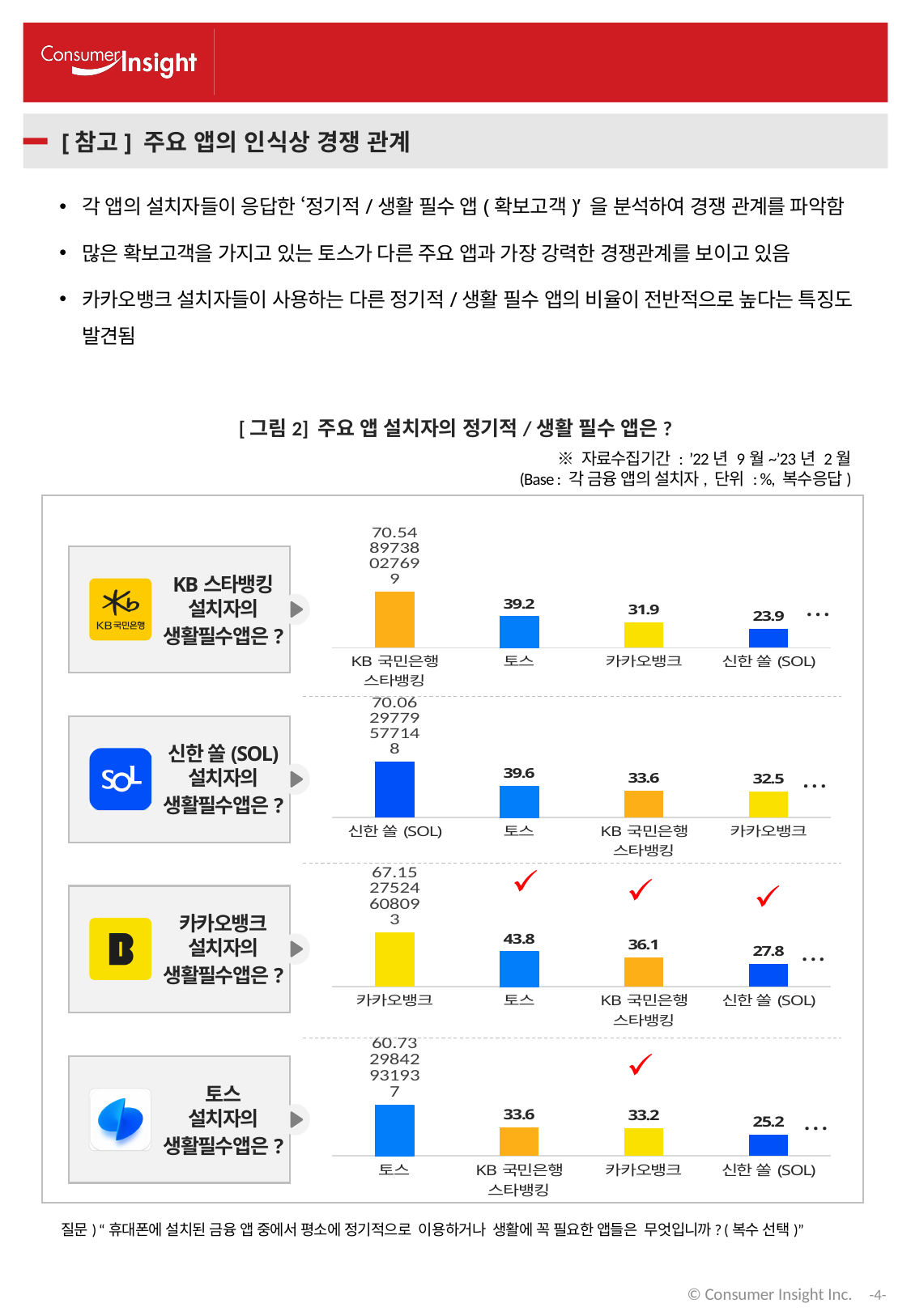
In the KB 스타뱅킹 설치자의 생활필수앱은? chart (top), what is the value for 신한 쏠 (SOL)? 23.9 In the 토스 설치자의 생활필수앱은? chart (bottom), which category has the lowest value? 신한 쏠 (SOL) In the 신한 쏠 (SOL) 설치자의 생활필수앱은? chart (second from top), what is the value for 카카오뱅크? 32.5 In the KB 스타뱅킹 설치자의 생활필수앱은? chart (top), what is the value for 토스? 39.2 In the KB 스타뱅킹 설치자의 생활필수앱은? chart (top), what is the difference between the values for 토스 and 카카오뱅크? 7.3 In the KB 스타뱅킹 설치자의 생활필수앱은? chart (top), which category has the highest value? KB 국민은행 스타뱅킹 What kind of chart is used for the 토스 설치자의 생활필수앱은? chart (bottom)? bar chart In the 카카오뱅크 설치자의 생활필수앱은? chart (third from top), what is the value for 토스? 43.8 In the 카카오뱅크 설치자의 생활필수앱은? chart (third from top), what is the difference between the values for 토스 and 신한 쏠 (SOL)? 16.0 How many bars are shown in the 카카오뱅크 설치자의 생활필수앱은? chart (third from top)? 4 In the 토스 설치자의 생활필수앱은? chart (bottom), what is the value for KB 국민은행 스타뱅킹? 33.6 In the 신한 쏠 (SOL) 설치자의 생활필수앱은? chart (second from top), which is larger, the value for 토스 or the value for 카카오뱅크? 토스